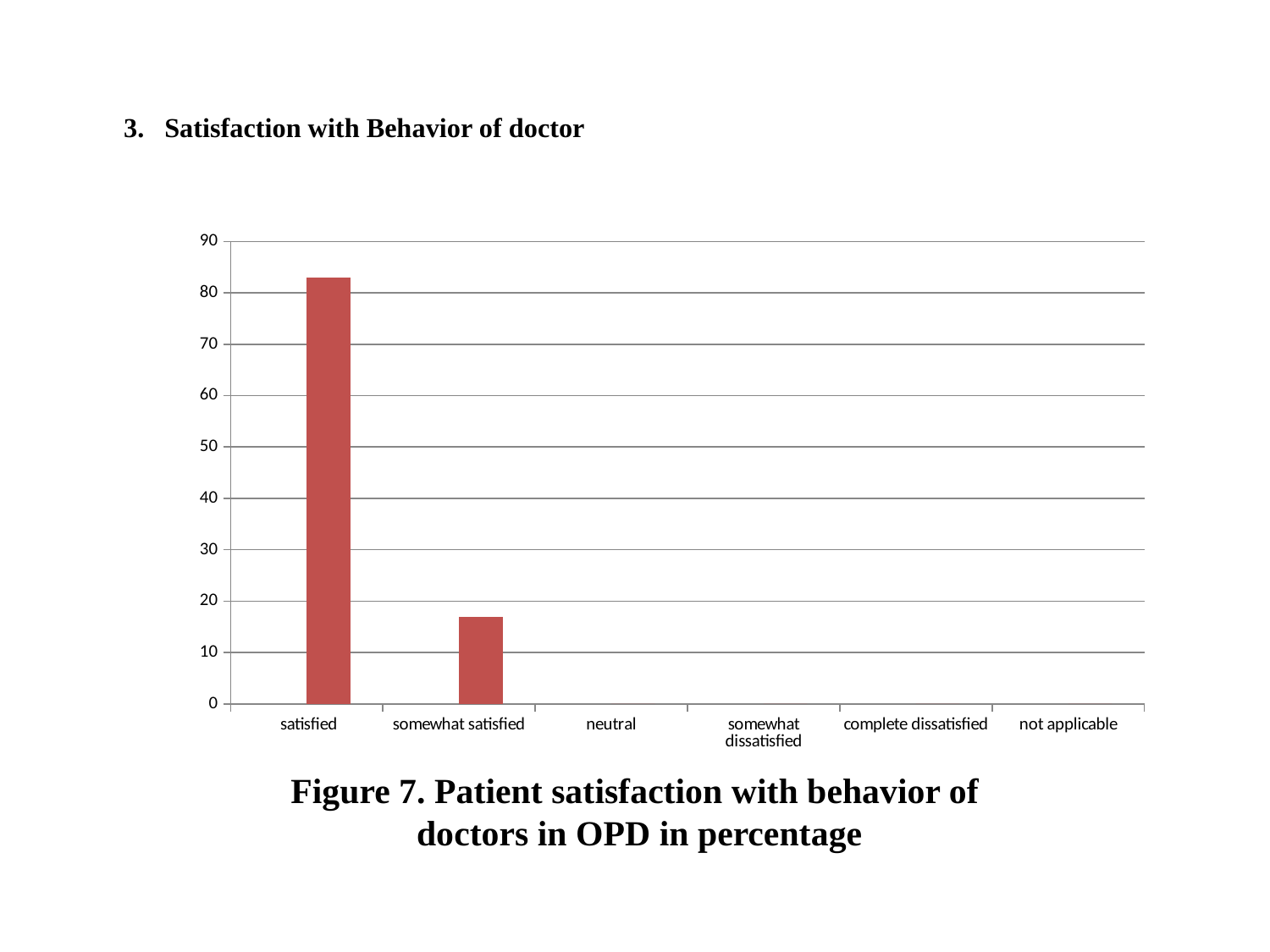
Which is larger, the value for satisfied or the value for somewhat satisfied? satisfied What kind of chart is shown on the slide? bar chart What is the figure caption below the chart? Figure 7. Patient satisfaction with behavior of doctors in OPD in percentage Is the value for satisfied greater or less than 80? greater Is the value for somewhat satisfied greater or less than 10? greater What is the highest value shown on the y axis of the chart? 90 Which category has the highest value in the chart? satisfied Is the value for somewhat satisfied greater or less than 20? less How many categories are shown on the x axis of the chart? 6